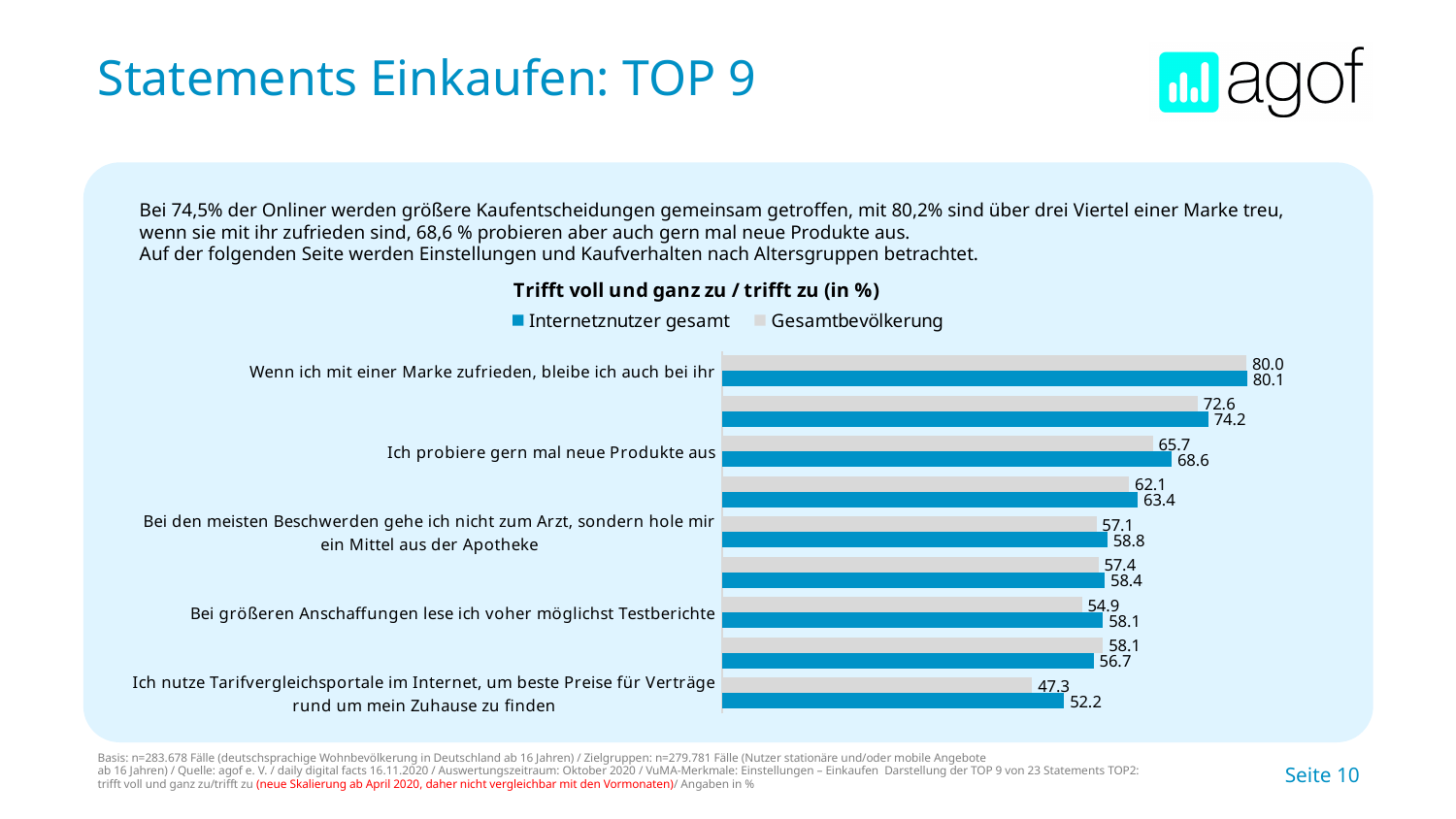
What value is shown for Internetznutzer gesamt for "Bei den meisten Beschwerden gehe ich nicht zum Arzt, sondern hole mir ein Mittel aus der Apotheke"? 58.8 How many series does the legend list? 2 What value is shown for Internetznutzer gesamt for "Wenn ich mit einer Marke zufrieden, bleibe ich auch bei ihr"? 80.1 What value is shown for Gesamtbevölkerung for "Bei größeren Anschaffungen lese ich voher möglichst Testberichte"? 54.9 What value is shown for Internetznutzer gesamt for "Ich nutze Tarifvergleichsportale im Internet, um beste Preise für Verträge rund um mein Zuhause zu finden"? 52.2 What is the difference between Internetznutzer gesamt and Gesamtbevölkerung for "Bei größeren Anschaffungen lese ich voher möglichst Testberichte"? 3.2 For "Ich probiere gern mal neue Produkte aus", which series has the larger value, Internetznutzer gesamt or Gesamtbevölkerung? Internetznutzer gesamt Which statement has the highest value for Internetznutzer gesamt? Wenn ich mit einer Marke zufrieden, bleibe ich auch bei ihr Which statement has the lowest value for Gesamtbevölkerung? Ich nutze Tarifvergleichsportale im Internet, um beste Preise für Verträge rund um mein Zuhause zu finden What kind of chart is shown on the slide? Bar chart What is the title of the chart? Trifft voll und ganz zu / trifft zu (in %) What value is shown for Gesamtbevölkerung for "Ich probiere gern mal neue Produkte aus"? 65.7